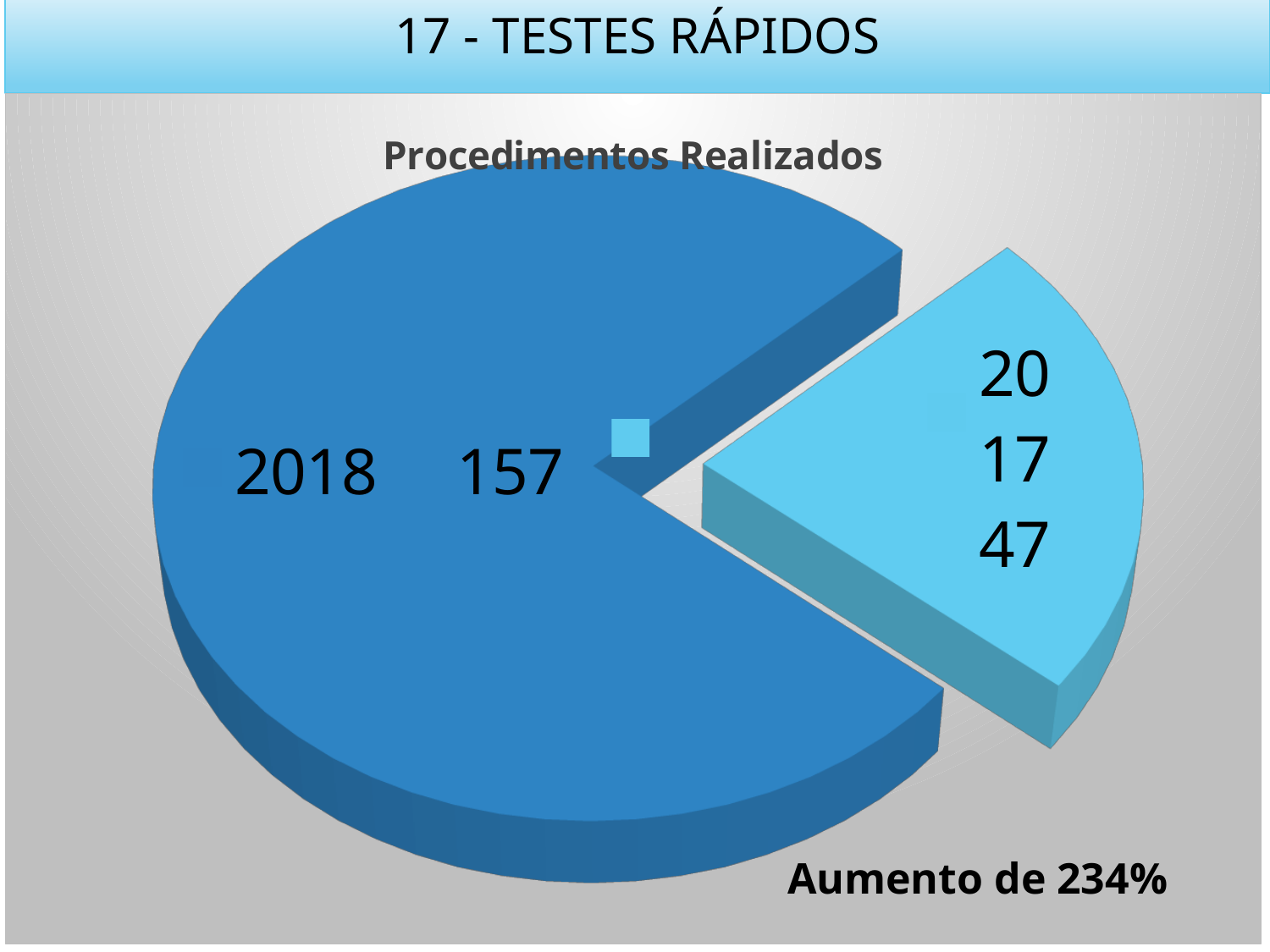
What kind of chart is shown on the slide? pie chart What is the value for 2017 in the Procedimentos Realizados pie chart? 47 Is the value for 2017 larger or smaller than the value for 2018 in the Procedimentos Realizados chart? smaller What is the title of the chart on the slide? Procedimentos Realizados Which year has the smaller slice in the Procedimentos Realizados chart? 2017 How many slices does the Procedimentos Realizados pie chart have? 2 What is the difference between the 2018 and 2017 values in the Procedimentos Realizados chart? 110 Which year has the larger slice in the Procedimentos Realizados chart? 2018 What is the total of the two values shown in the Procedimentos Realizados pie chart? 204 What percentage increase is stated in the text below the chart? 234% What is the value for 2018 in the Procedimentos Realizados pie chart? 157